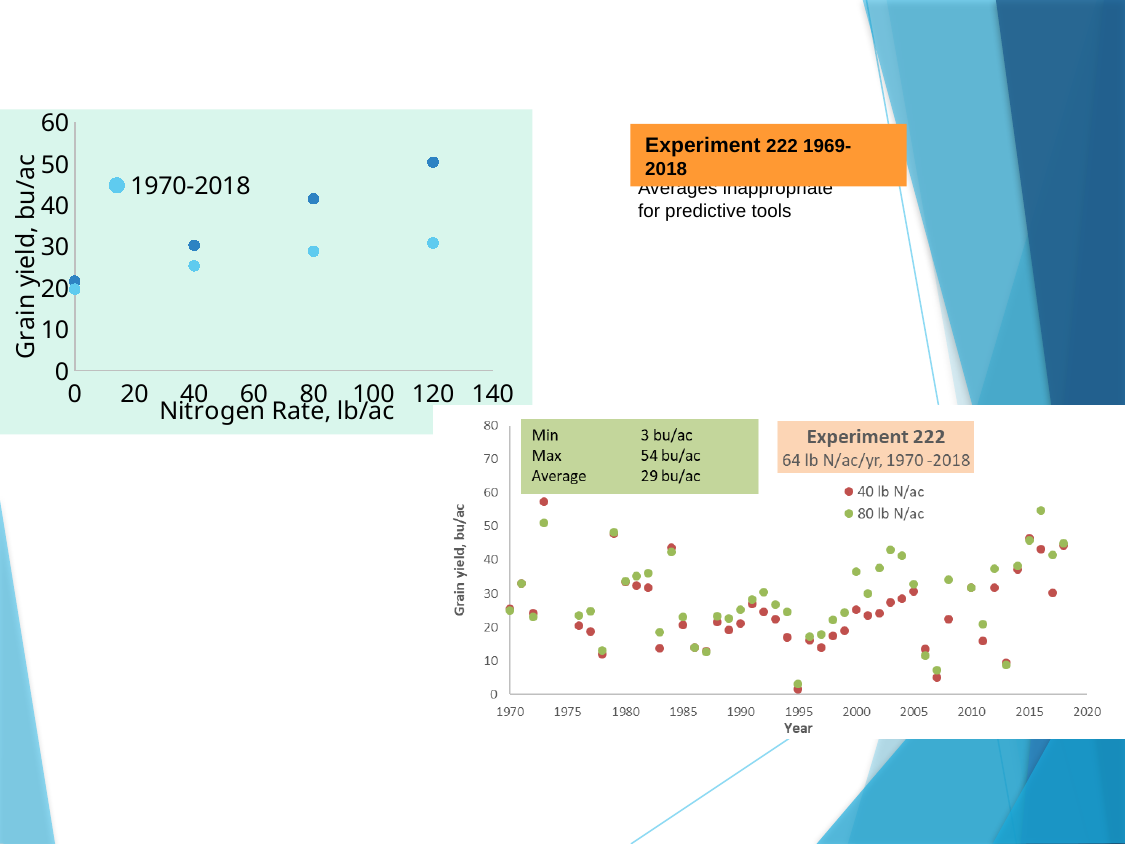
In the top-left chart, is the lighter blue point at a nitrogen rate of 40 greater or less than 30? less What kind of chart is the top-left chart with Nitrogen Rate on the x axis? scatter chart In the top-left chart, how many nitrogen rates have points plotted? 4 In the top-left chart, is the darker blue point at a nitrogen rate of 120 greater or less than 40? greater In the Experiment 222 chart at the bottom right, how many series does the legend list? 2 In the top-left chart, at a nitrogen rate of 120, is the darker blue point higher or lower than the lighter blue point? higher In the Experiment 222 chart at the bottom right, what are the two legend entries? 40 lb N/ac and 80 lb N/ac In the top-left chart, do the grain yield values rise or fall as the nitrogen rate increases? rise In the top-left chart, is the lighter blue point at a nitrogen rate of 120 greater or less than 40? less In the Experiment 222 chart at the bottom right, what is the maximum grain yield stated in the box? 54 bu/ac In the top-left chart, what is the title of the x axis? Nitrogen Rate, lb/ac In the Experiment 222 chart at the bottom right, what is the average grain yield stated in the box? 29 bu/ac